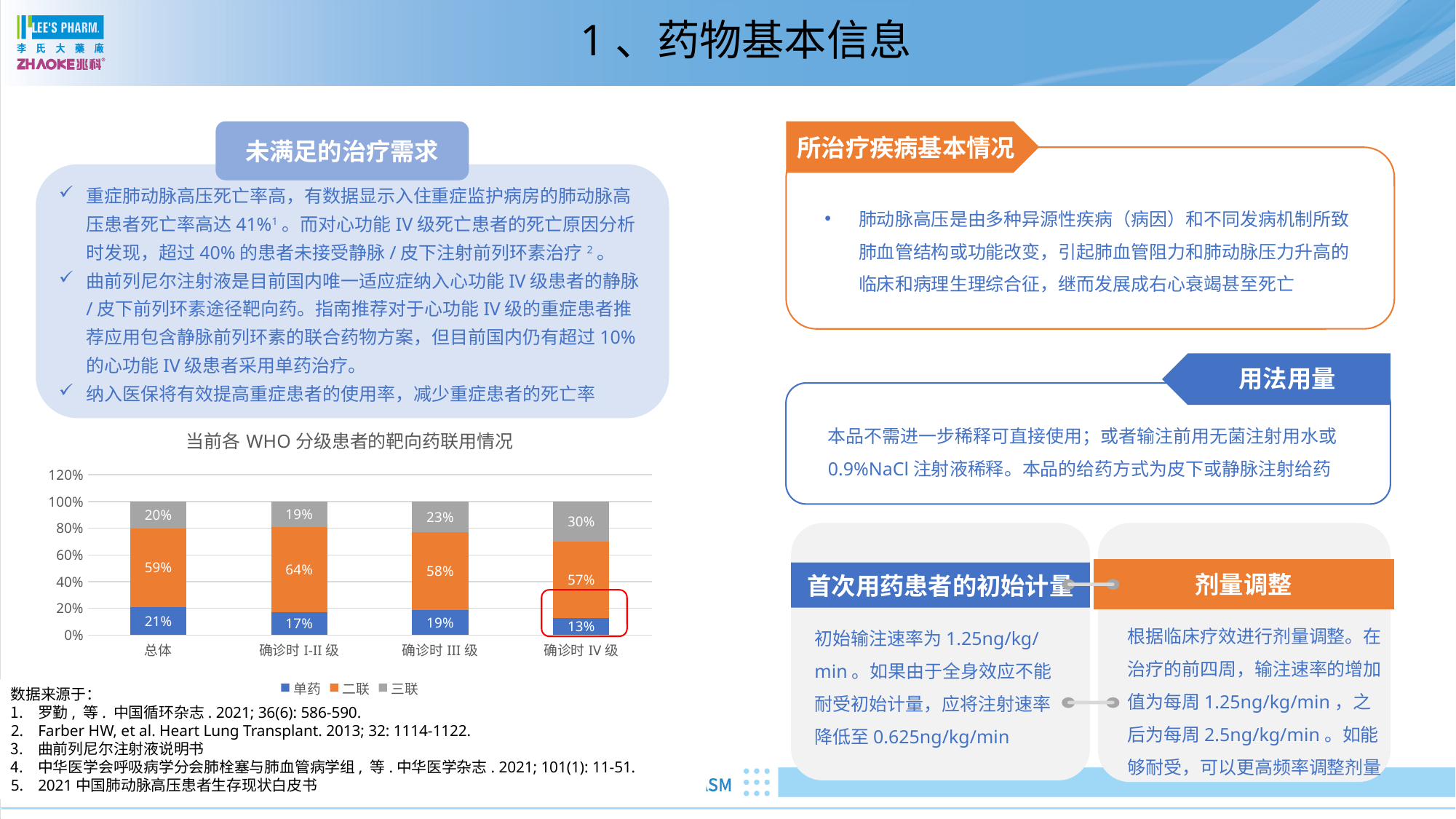
Which is larger, the 二联 value for 确诊时 I-II 级 or for 确诊时 III 级? 确诊时 I-II 级 What is the value of 二联 for 确诊时 I-II 级? 64% What is the difference between the 三联 value for 确诊时 IV 级 and for 总体? 10% What is the value of 单药 for 总体? 21% Which category has the highest 三联 value? 确诊时 IV 级 What kind of chart is shown on the slide? Stacked bar chart How many series does the legend list? 3 How many categories are shown on the x axis? 4 What is the title of the chart? 当前各 WHO 分级患者的靶向药联用情况 Which category has the lowest 单药 value? 确诊时 IV 级 What is the value of 单药 for 确诊时 IV 级? 13% What is the value of 三联 for 确诊时 III 级? 23%